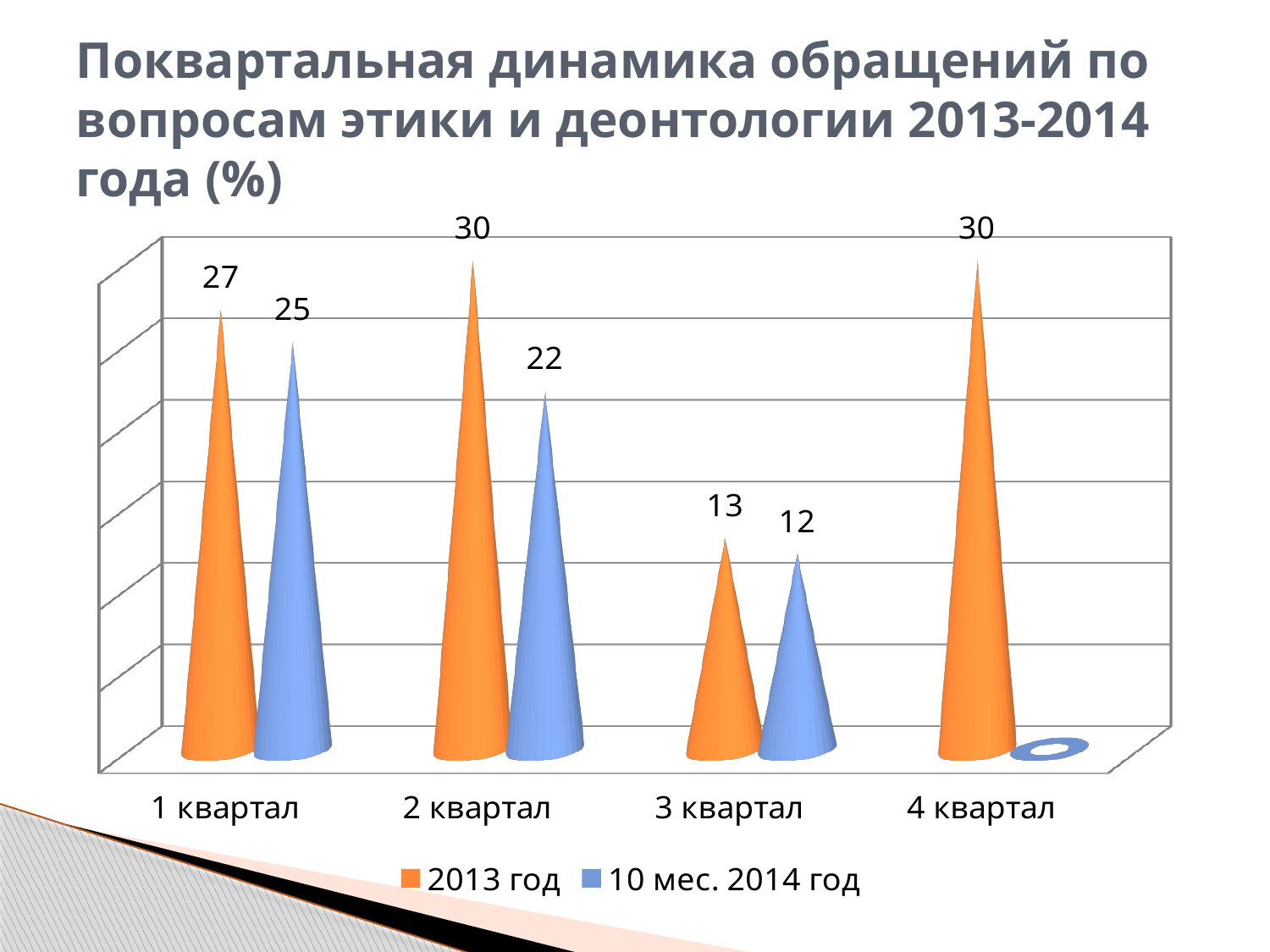
In which quarter is the value for 10 мес. 2014 год the highest? 1 квартал What is the value for 10 мес. 2014 год in 2 квартал? 22 What is the value for 2013 год in 1 квартал? 27 Which is larger in 1 квартал: the value for 2013 год or for 10 мес. 2014 год? 2013 год How many quarters are shown on the x axis? 4 What is the difference between the 2013 год and 10 мес. 2014 год values in 2 квартал? 8 In which quarter is the value for 2013 год the lowest? 3 квартал Which colour represents the series 10 мес. 2014 год? blue What kind of chart is shown on the slide? bar chart What is the value for 10 мес. 2014 год in 3 квартал? 12 What is the value for 2013 год in 4 квартал? 30 How many series does the legend list? 2